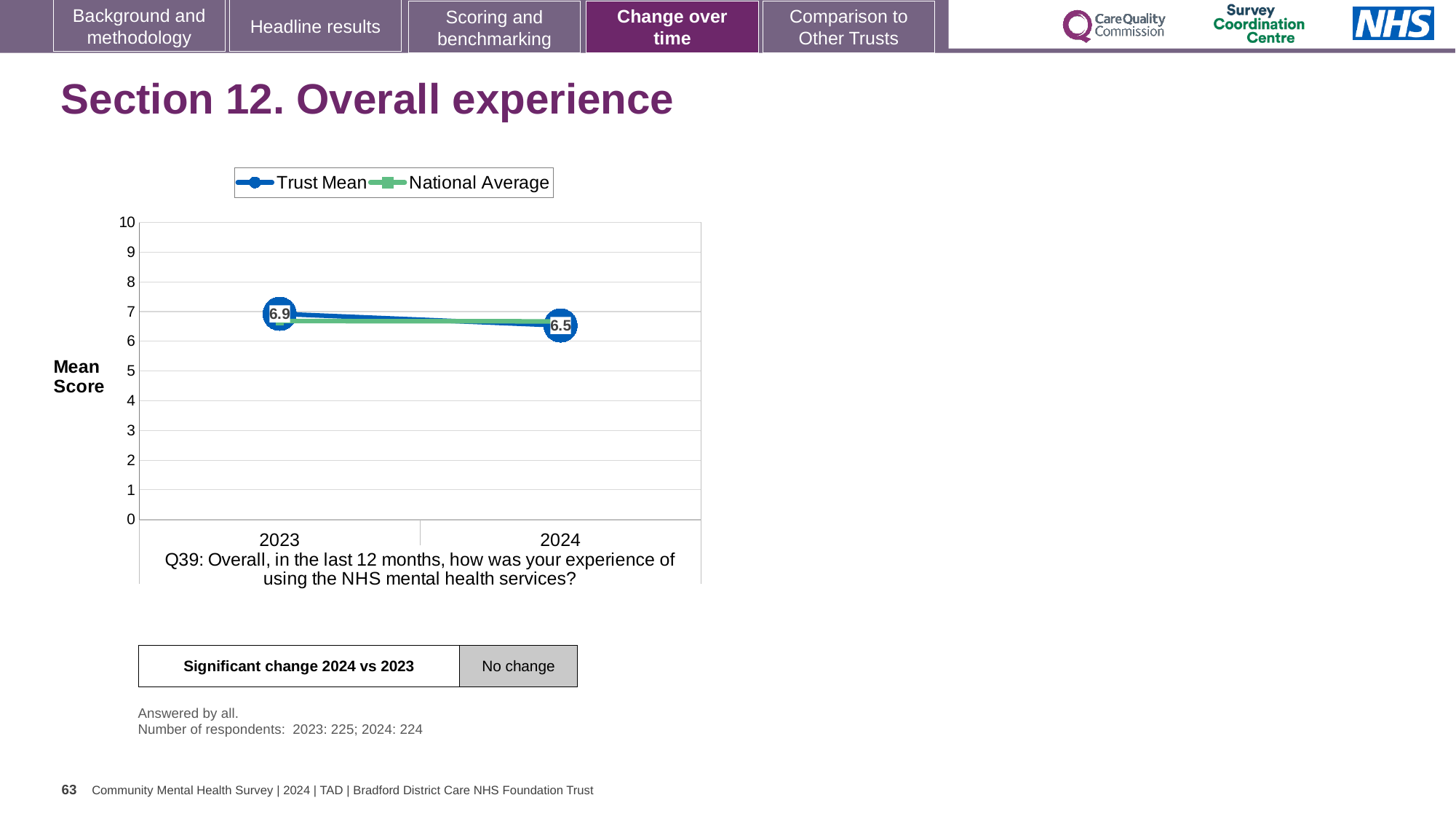
How many series does the legend list? 2 What kind of chart is shown on the slide? line chart By how much did the Trust Mean change from 2023 to 2024? 0.4 What are the two series named in the legend? Trust Mean and National Average Is the Trust Mean higher in 2023 or in 2024? 2023 Does the Trust Mean rise or fall from 2023 to 2024? fall What is the label on the y axis of the chart? Mean Score What is the Trust Mean value for 2024? 6.5 Is the National Average value for 2024 greater or less than 8? less How many years are plotted on the x axis? 2 What is the Trust Mean value for 2023? 6.9 Is the National Average value for 2023 greater or less than 5? greater